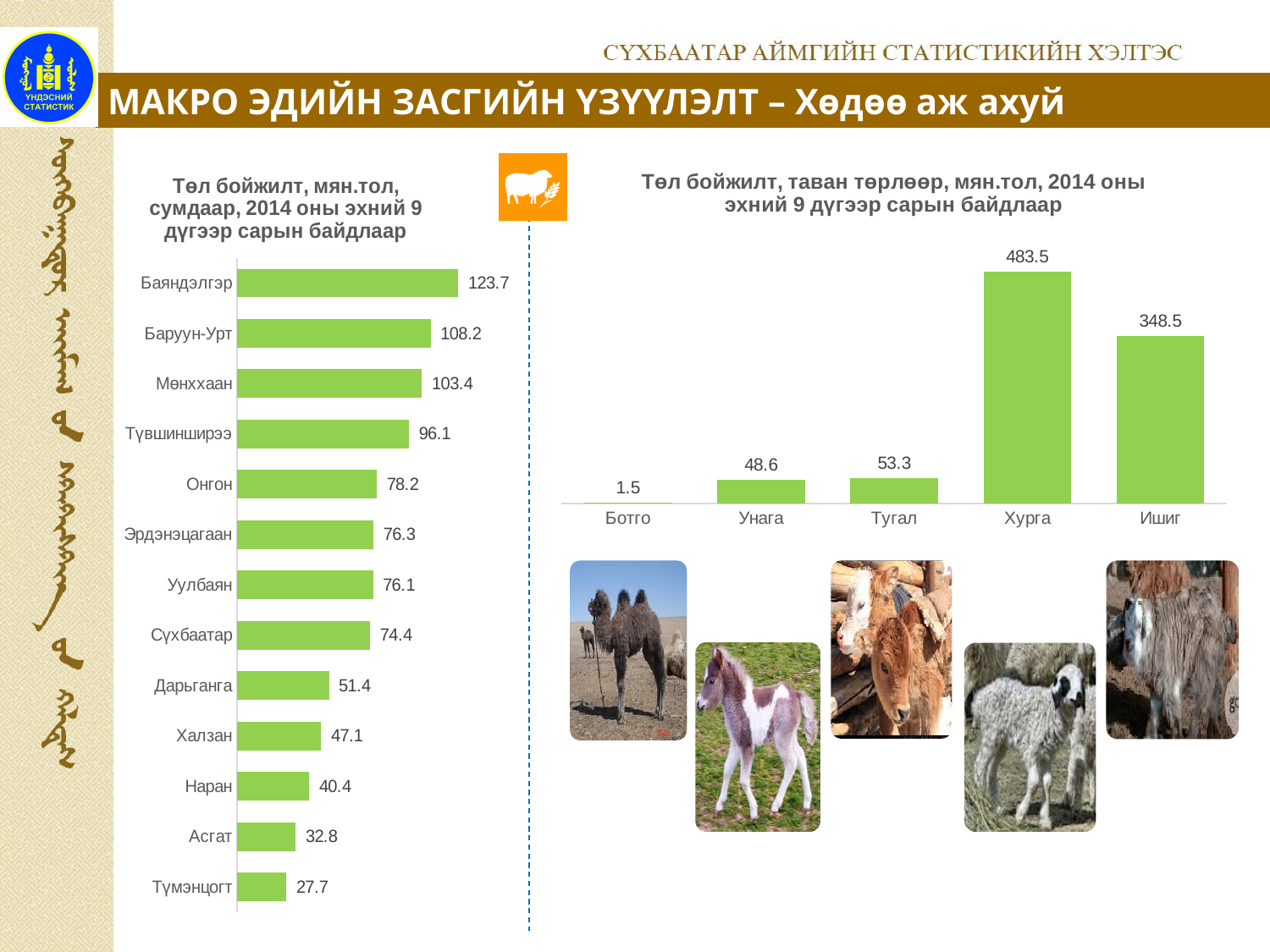
In the right chart (Төл бойжилт, таван төрлөөр), what is the value for Ботго? 1.5 In the left chart (Төл бойжилт, сумдаар), what is the value for Дарьганга? 51.4 In the right chart (Төл бойжилт, таван төрлөөр), how many categories are shown? 5 In the left chart (Төл бойжилт, сумдаар), which is larger, Онгон or Сүхбаатар? Онгон In the left chart (Төл бойжилт, сумдаар), what is the value for Баяндэлгэр? 123.7 In the left chart (Төл бойжилт, сумдаар), how many soums are shown? 13 In the right chart (Төл бойжилт, таван төрлөөр), which category has the highest value? Хурга In the right chart (Төл бойжилт, таван төрлөөр), what is the value for Хурга? 483.5 In the left chart (Төл бойжилт, сумдаар), which soum has the lowest value? Түмэнцогт In the right chart (Төл бойжилт, таван төрлөөр), what is the difference between Хурга and Ишиг? 135.0 In the left chart (Төл бойжилт, сумдаар), what is the difference between Баруун-Урт and Мөнххаан? 4.8 What type of chart is the right chart (Төл бойжилт, таван төрлөөр)? Bar chart